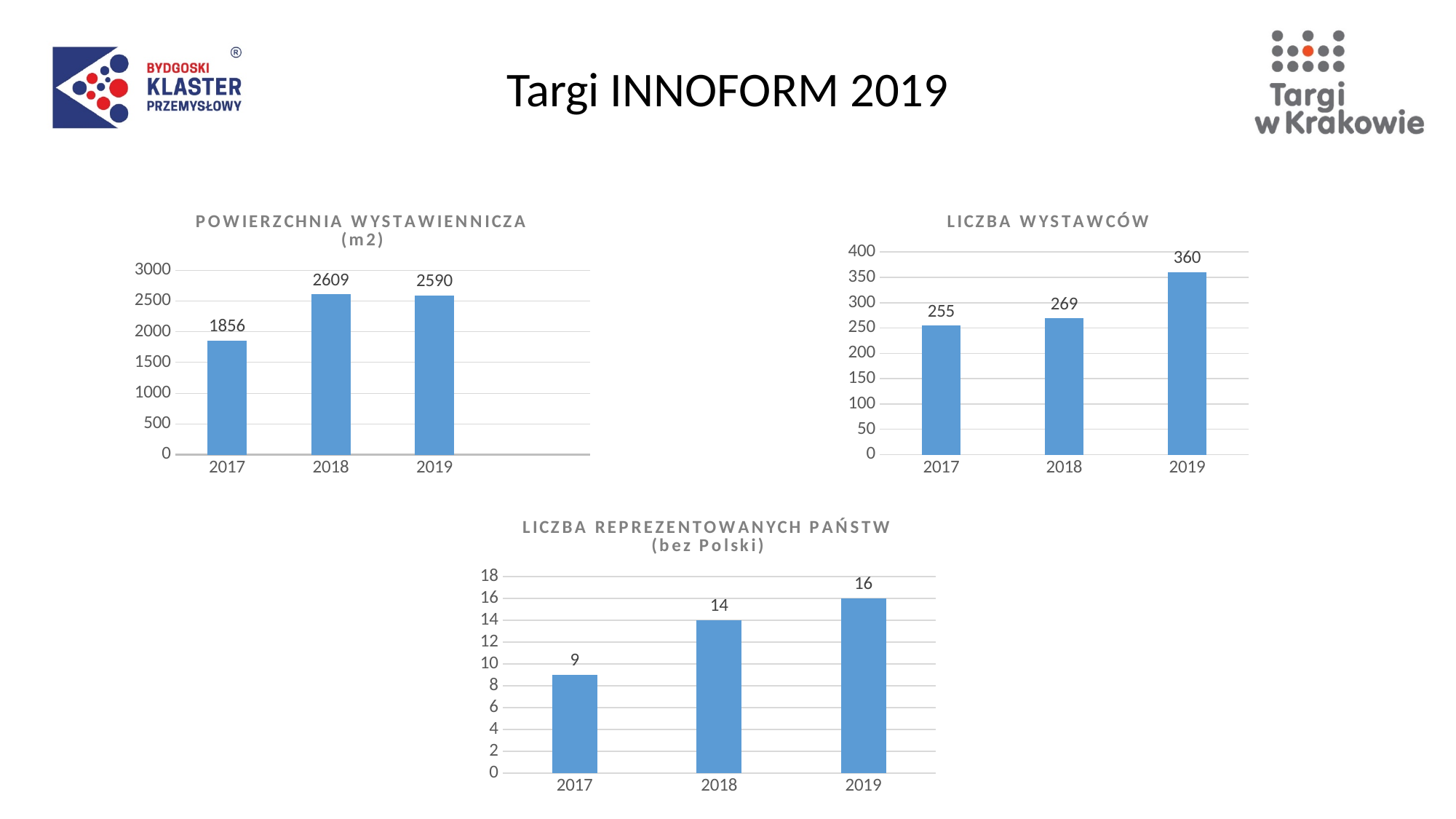
In the 'LICZBA WYSTAWCÓW' chart, which year has the lowest value? 2017 In the 'POWIERZCHNIA WYSTAWIENNICZA (m2)' chart, which year has the highest value? 2018 In the 'POWIERZCHNIA WYSTAWIENNICZA (m2)' chart, what is the value for 2017? 1856 In the 'LICZBA WYSTAWCÓW' chart, what is the difference between the 2019 and 2018 values? 91 In the 'LICZBA WYSTAWCÓW' chart, what is the value for 2019? 360 In the 'LICZBA REPREZENTOWANYCH PAŃSTW (bez Polski)' chart, how many years are shown on the x axis? 3 In the 'POWIERZCHNIA WYSTAWIENNICZA (m2)' chart, what is the difference between the 2018 and 2019 values? 19 In the 'LICZBA REPREZENTOWANYCH PAŃSTW (bez Polski)' chart, which is larger, the value for 2017 or 2019? 2019 In the 'LICZBA WYSTAWCÓW' chart, do the values rise or fall from 2017 to 2019? rise What kind of chart is the 'LICZBA REPREZENTOWANYCH PAŃSTW (bez Polski)' chart? bar chart In the 'LICZBA REPREZENTOWANYCH PAŃSTW (bez Polski)' chart, what is the value for 2018? 14 How many charts are shown on the slide? 3